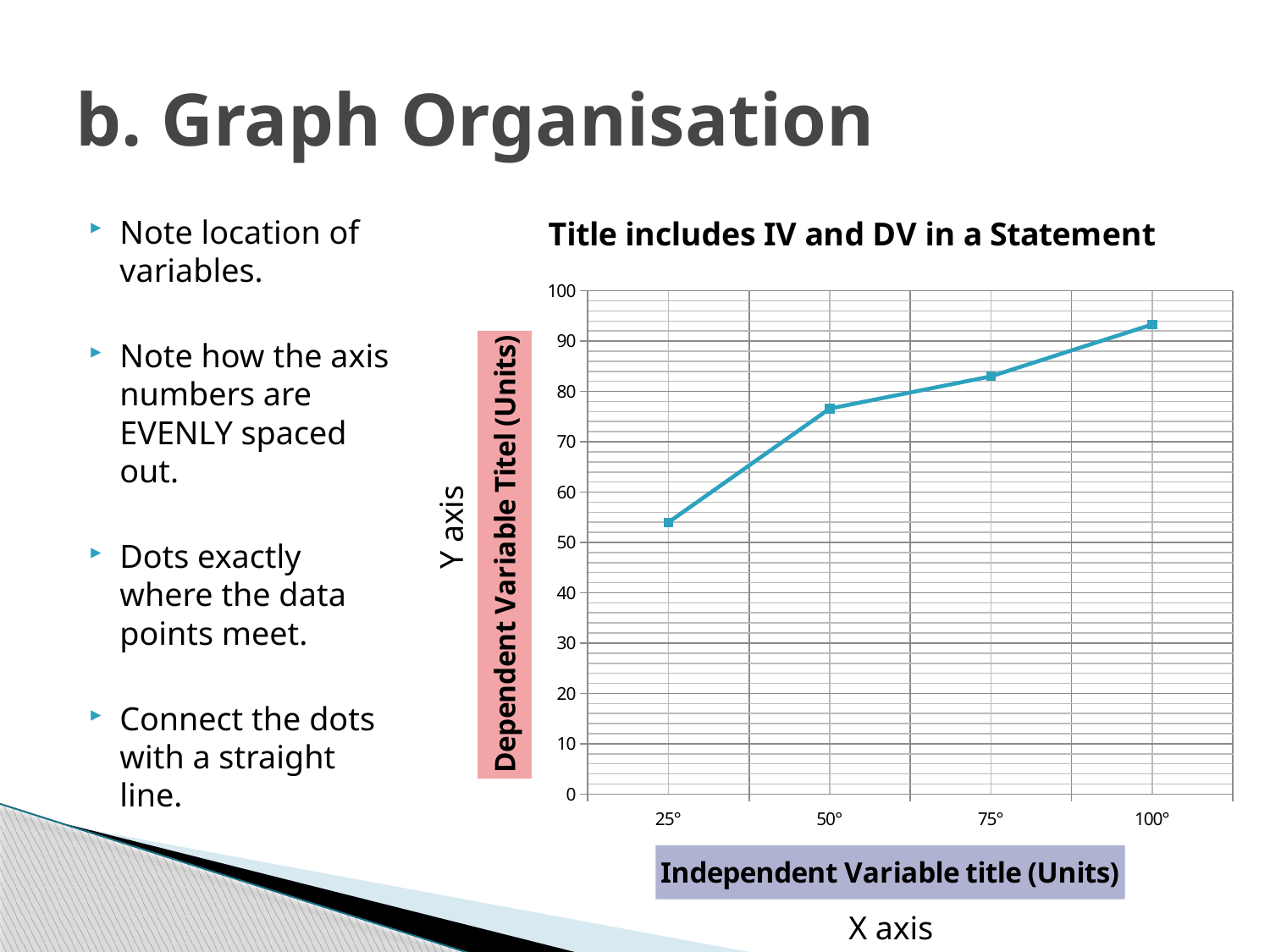
Is the value at 75° greater or less than 90? less Which x-axis category has the highest value? 100° Is the value at 25° greater or less than 60? less Which has the larger value, 25° or 50°? 50° Is the value at 100° greater or less than 90? greater How many data points are plotted on the chart? 4 Do the values rise or fall as you move from 25° to 100° along the x axis? rise Which x-axis category has the lowest value? 25° What is the title of the chart? Title includes IV and DV in a Statement What kind of chart is shown on the slide? line chart